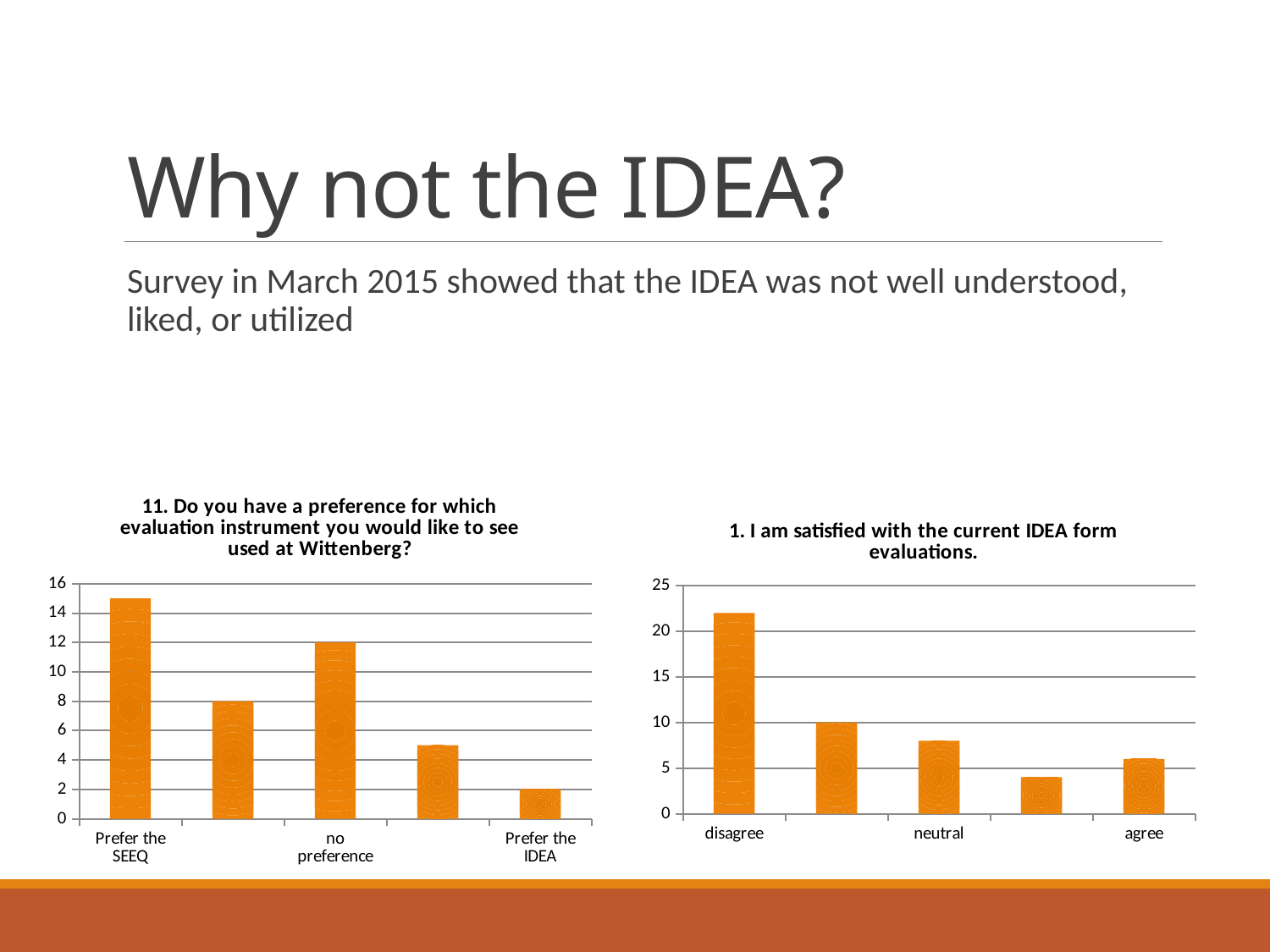
In the right chart ("1. I am satisfied with the current IDEA form evaluations."), is the value for "agree" greater or less than 10? less What kind of chart is the chart titled "1. I am satisfied with the current IDEA form evaluations."? bar chart In the right chart ("1. I am satisfied with the current IDEA form evaluations."), is the value for "disagree" greater or less than 20? greater In the left chart (question 11), which labelled category has the lowest value? Prefer the IDEA In the right chart ("1. I am satisfied with the current IDEA form evaluations."), which is larger, the value for "neutral" or the value for "agree"? neutral In the left chart (question 11), what is the difference between the values for "no preference" and "Prefer the IDEA"? 10 In the chart titled "11. Do you have a preference for which evaluation instrument you would like to see used at Wittenberg?", what is the value for "no preference"? 12 In the left chart (question 11), is the value for "Prefer the SEEQ" greater or less than 14? greater How many bars are plotted in the left chart (question 11)? 5 In the left chart (question 11), what is the value for "Prefer the IDEA"? 2 In the right chart ("1. I am satisfied with the current IDEA form evaluations."), which category has the highest value? disagree In the left chart (question 11), which category has the highest value? Prefer the SEEQ